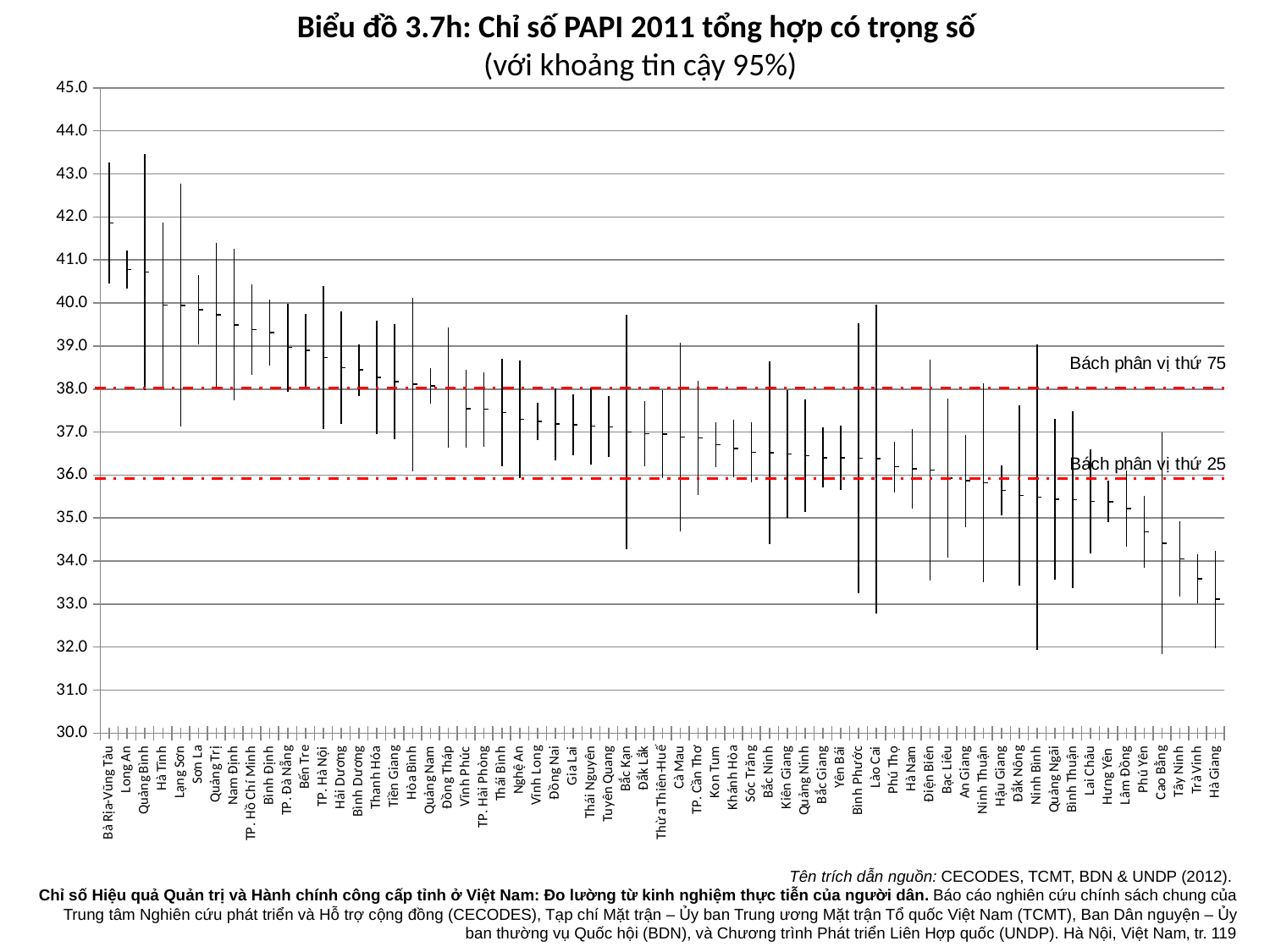
Is the index value for Bà Rịa-Vũng Tàu greater or less than 40.0? greater What kind of chart is shown on the slide? Error bar (confidence interval) chart Which province has the highest weighted PAPI 2011 index? Bà Rịa-Vũng Tàu How many provinces are plotted along the x axis? 63 Is the index value for Hà Giang greater or less than 34.0? less What do the two red dash-dot horizontal lines represent? Bách phân vị thứ 75 and Bách phân vị thứ 25 Is the index value for Cao Bằng greater or less than 35.0? less What is the maximum value shown on the y axis? 45.0 Which province has the lowest weighted PAPI 2011 index? Hà Giang Which has the larger index value, Long An or Cao Bằng? Long An What is the title of the chart? Biểu đồ 3.7h: Chỉ số PAPI 2011 tổng hợp có trọng số (với khoảng tin cậy 95%) Do the index values rise or fall moving from left to right along the x axis? Fall